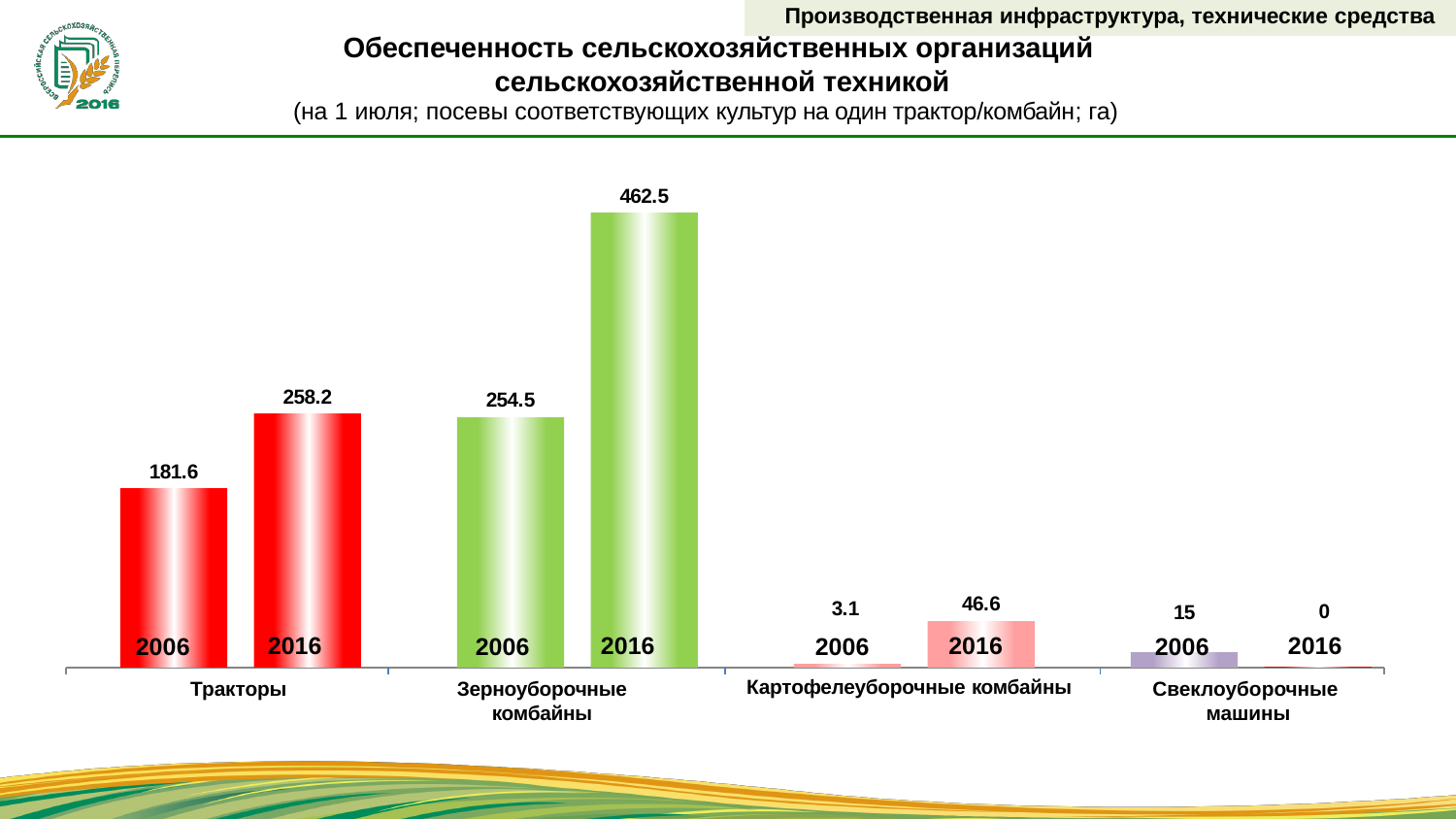
Which category has the lowest value in 2006? Картофелеуборочные комбайны What is the value for Тракторы in 2006? 181.6 What is the value for Свеклоуборочные машины in 2016? 0 Which category has the highest value in 2016? Зерноуборочные комбайны What is the difference between the 2016 and 2006 values for Тракторы? 76.6 What is the value for Зерноуборочные комбайны in 2016? 462.5 What kind of chart is shown on the slide? Bar chart What is the value for Картофелеуборочные комбайны in 2006? 3.1 What is the difference between the 2016 and 2006 values for Зерноуборочные комбайны? 208 How many equipment categories are shown on the chart? 4 Did the value for Свеклоуборочные машины rise or fall from 2006 to 2016? Fall Which is larger: the 2006 value for Тракторы or the 2006 value for Зерноуборочные комбайны? Зерноуборочные комбайны